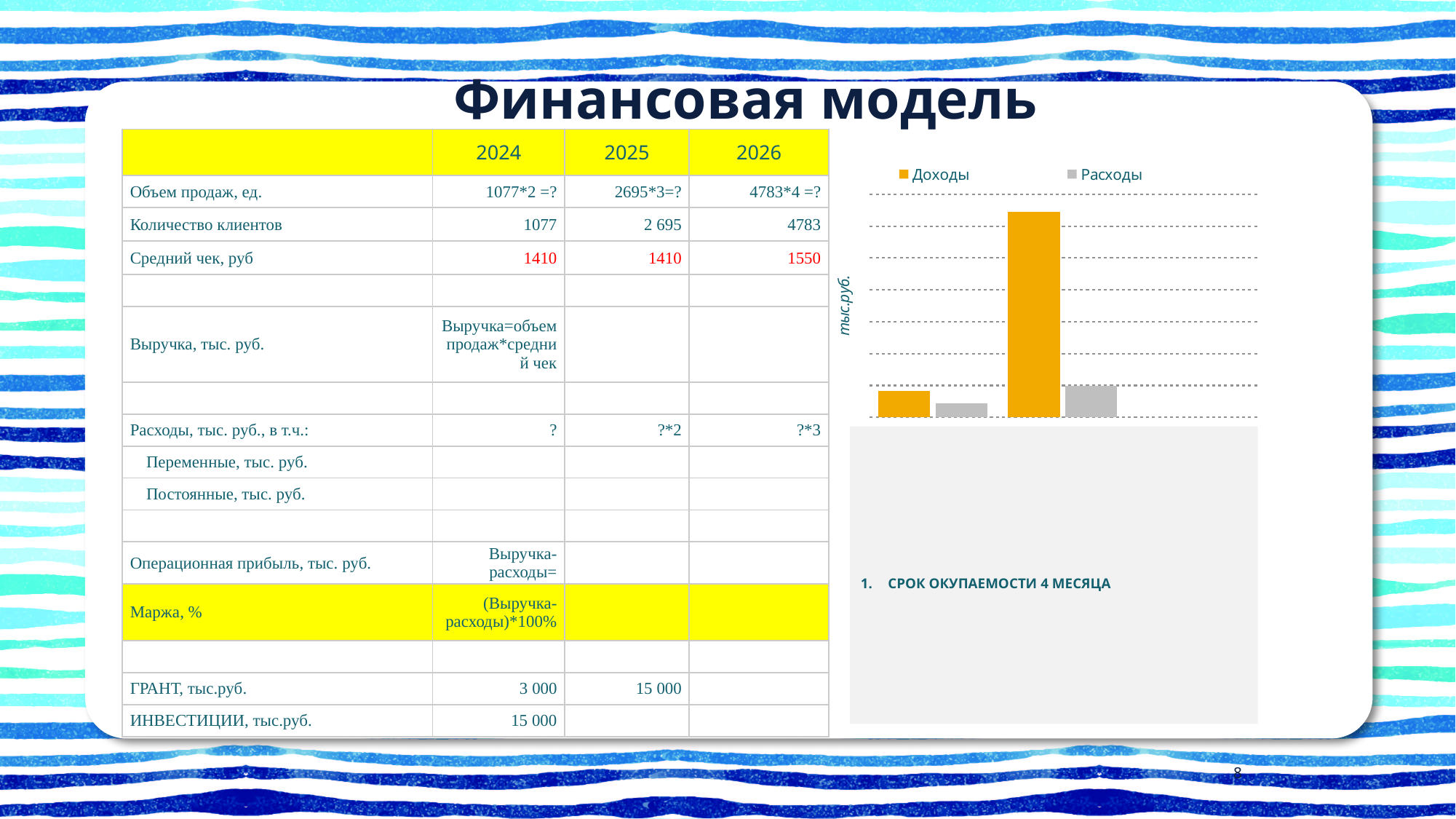
How many series does the legend of the chart list? 2 Which bar in the chart is the shortest? Расходы in the first group What unit is written on the vertical axis of the chart? тыс.руб. What are the two series named in the chart legend? Доходы and Расходы Do the Расходы bars rise or fall from the first group to the second group? rise Do the Доходы bars rise or fall from the first group to the second group? rise What kind of chart is shown on the right side of the slide? bar chart In the first (left) group of bars, which series is larger, Доходы or Расходы? Доходы Which bar in the chart is the tallest? Доходы in the second group Which series is shown in orange in the chart? Доходы In the second (right) group of bars, which series is larger, Доходы or Расходы? Доходы How many groups of bars are plotted in the chart? 2